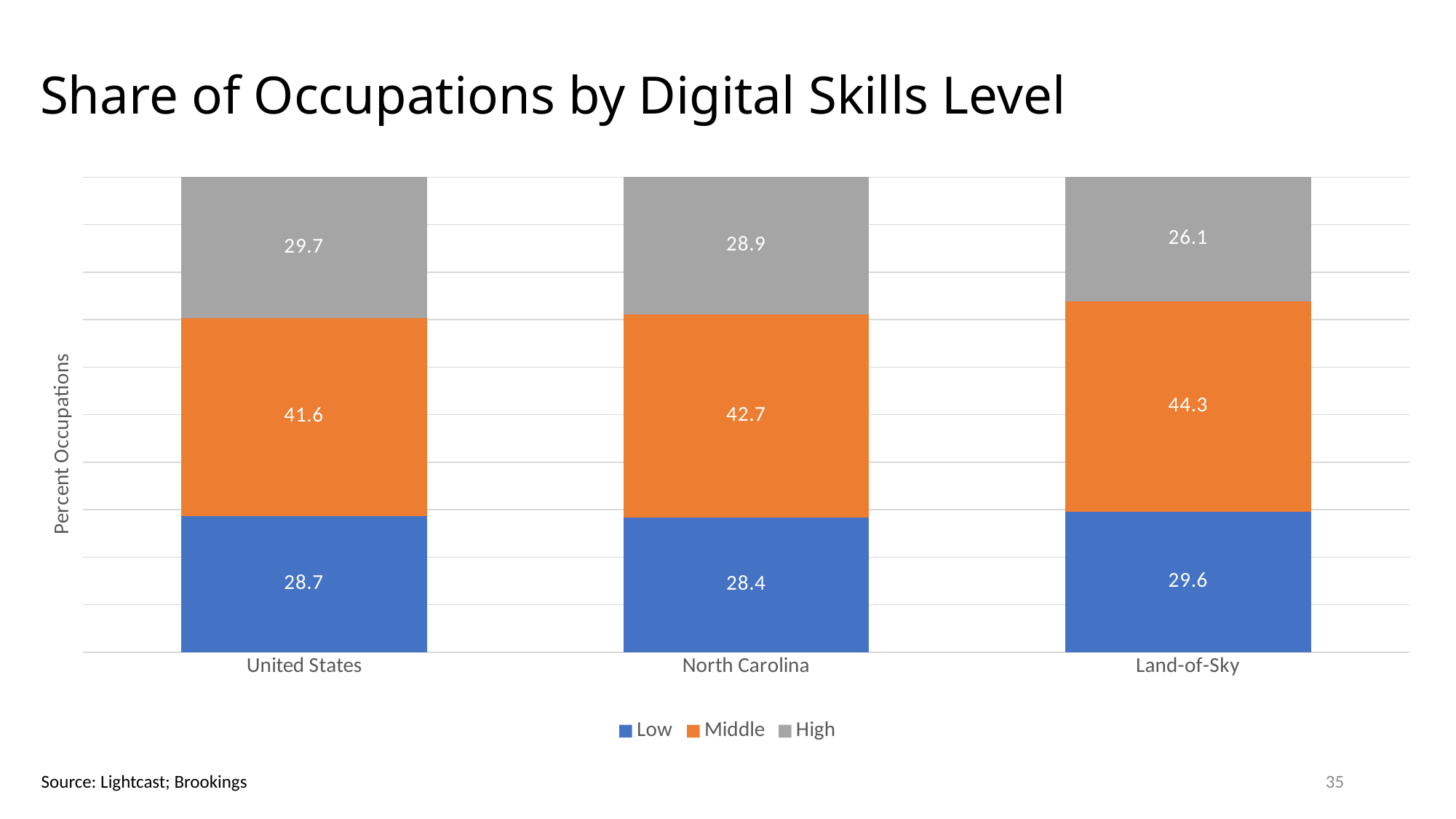
What is the Middle value for Land-of-Sky? 44.3 What is the High value for United States? 29.7 How many categories are shown on the x axis? 3 What is the title of the chart? Share of Occupations by Digital Skills Level What is the total of the stacked bar for North Carolina? 100.0 Which is larger, the High value for United States or the High value for Land-of-Sky? United States What kind of chart is shown on the slide? Stacked bar chart What is the difference between the Middle values for Land-of-Sky and United States? 2.7 What is the Low value for North Carolina? 28.4 Which category has the lowest High value? Land-of-Sky Which category has the highest Middle value? Land-of-Sky How many series does the legend list? 3